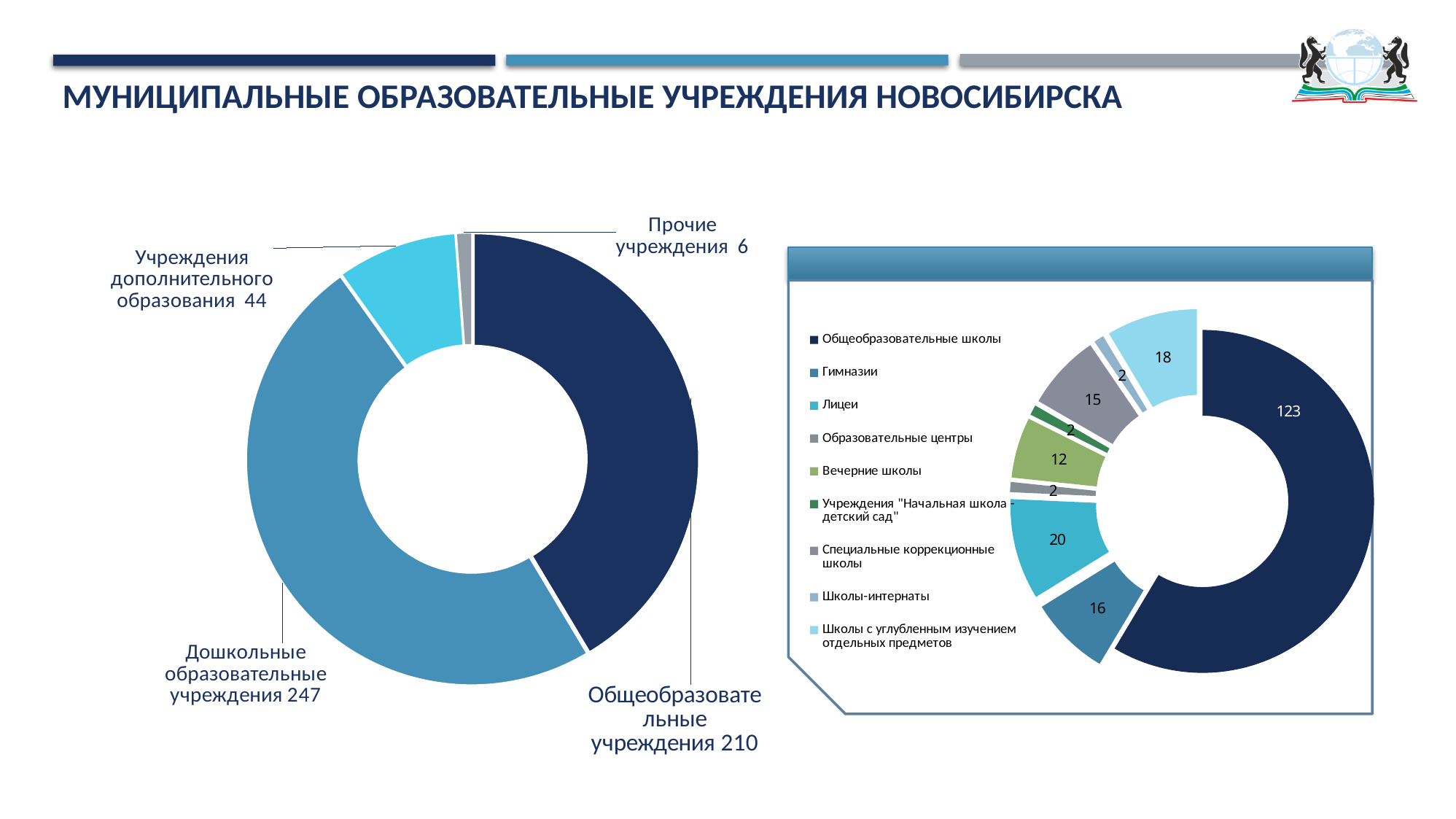
What type of chart is the left chart? Donut chart On the right chart, which category has the largest value? Общеобразовательные школы On the left chart, what is the value for Прочие учреждения? 6 On the left chart, which category has the largest value? Дошкольные образовательные учреждения How many entries does the legend of the right chart list? 9 On the right chart, what is the value for Лицеи? 20 On the right chart, which is larger: Гимназии or Школы с углубленным изучением отдельных предметов? Школы с углубленным изучением отдельных предметов On the left chart, what is the difference between Дошкольные образовательные учреждения and Общеобразовательные учреждения? 37 On the right chart, what is the difference between Специальные коррекционные школы and Вечерние школы? 3 On the left chart, how many categories are shown? 4 On the left chart, what is the value for Дошкольные образовательные учреждения? 247 On the right chart, what is the value for Общеобразовательные школы? 123